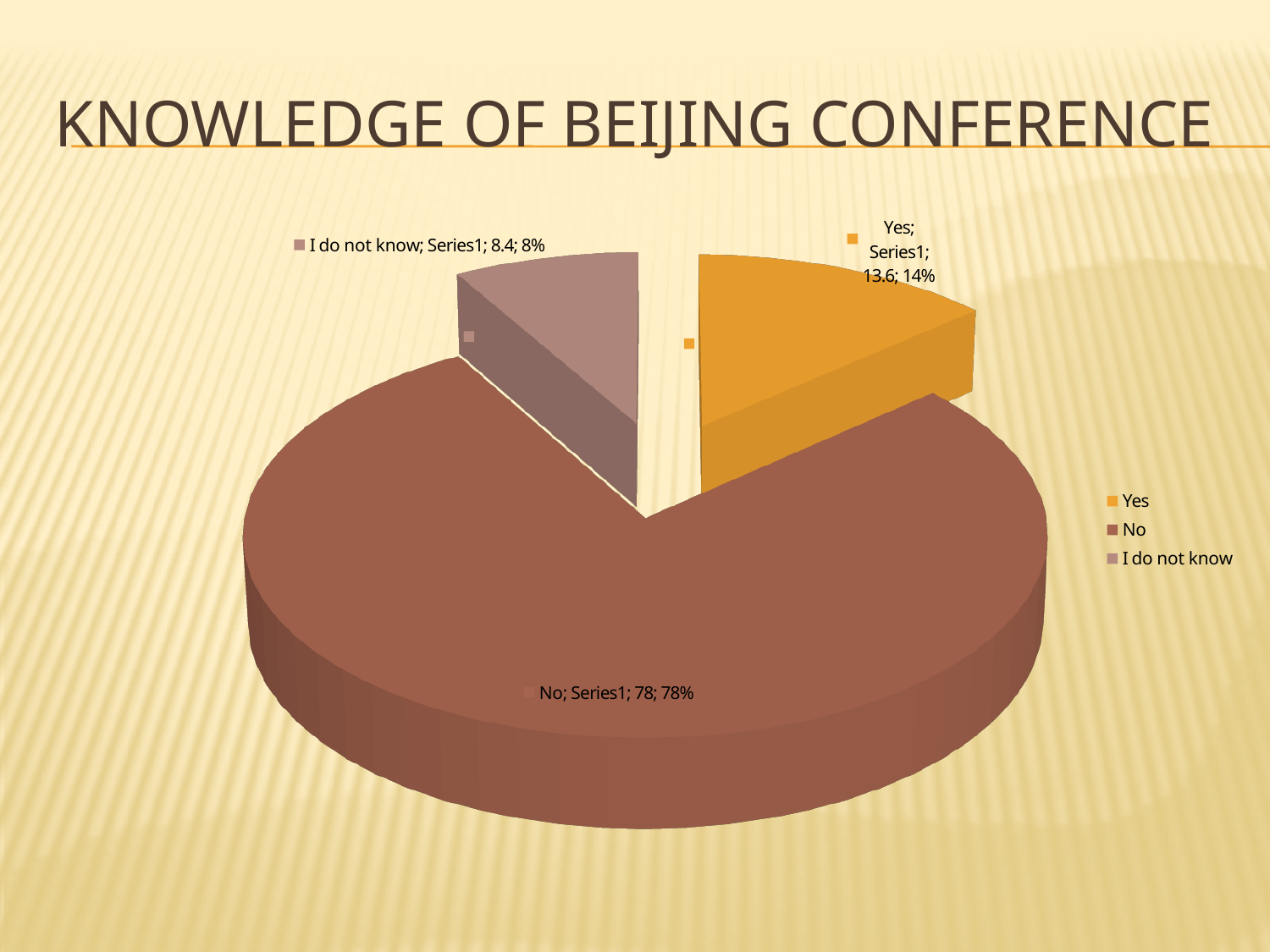
What percentage share does the "No" slice have? 78% Which category has the largest slice? No What is the difference between the values for "Yes" and "I do not know"? 5.2 What is the title of the slide containing the chart? KNOWLEDGE OF BEIJING CONFERENCE What is the value for the "I do not know" slice? 8.4 What kind of chart is shown on the slide? pie chart What percentage share does the "Yes" slice have? 14% Which category has the smallest slice? I do not know What percentage share does the "I do not know" slice have? 8% What is the value for the "Yes" slice? 13.6 What is the value for the "No" slice? 78 How many categories does the pie chart have? 3